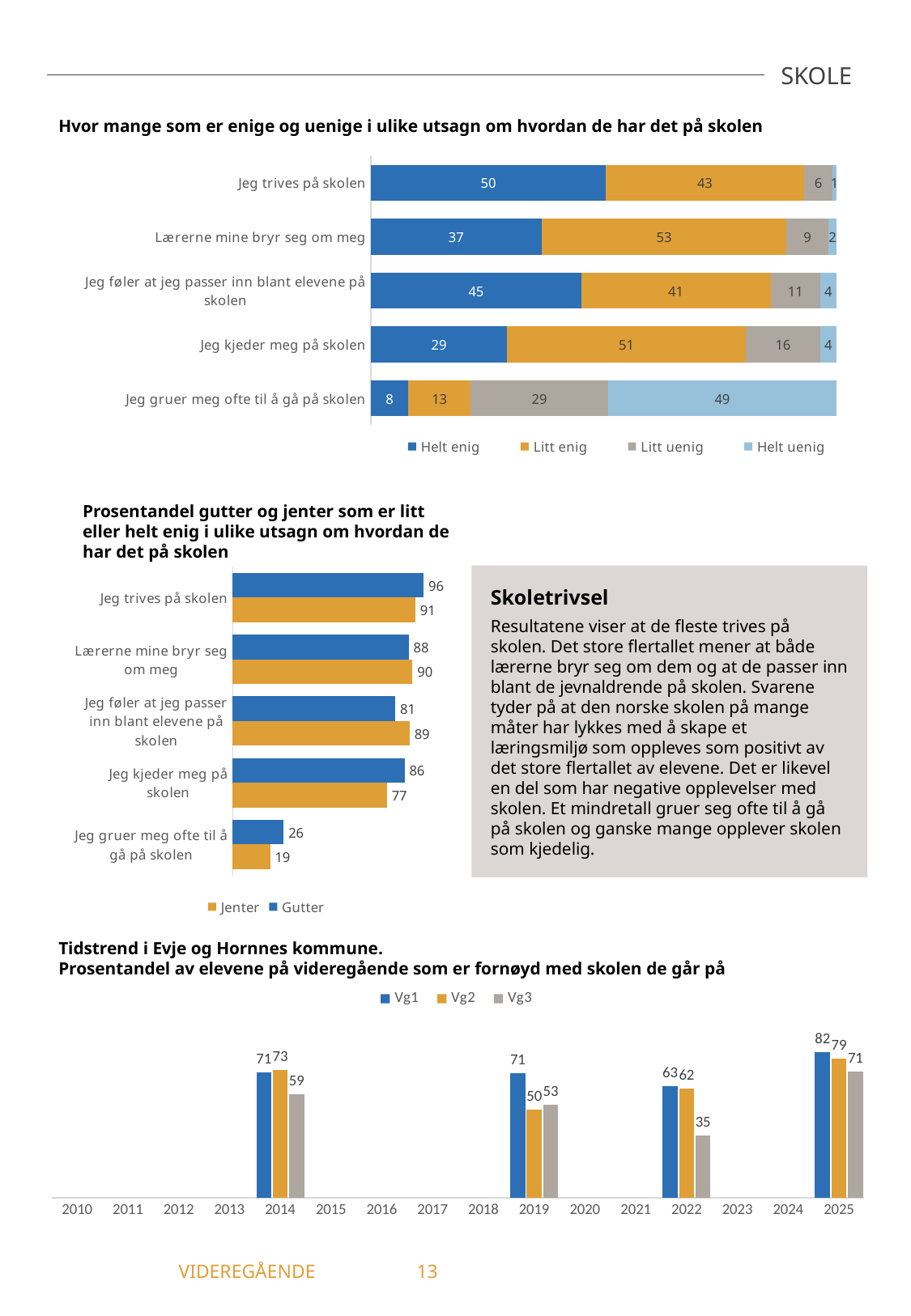
How many series does the legend of the top chart 'Hvor mange som er enige og uenige i ulike utsagn om hvordan de har det på skolen' list? 4 In the middle chart 'Prosentandel gutter og jenter som er litt eller helt enig i ulike utsagn om hvordan de har det på skolen', what is the value for Gutter on 'Jeg trives på skolen'? 96 What kind of chart is the bottom chart 'Tidstrend i Evje og Hornnes kommune'? Bar chart In the top chart 'Hvor mange som er enige og uenige i ulike utsagn om hvordan de har det på skolen', which statement has the highest 'Litt enig' value? Lærerne mine bryr seg om meg In the bottom chart 'Tidstrend i Evje og Hornnes kommune', what is the Vg3 value for 2022? 35 In the middle chart 'Prosentandel gutter og jenter som er litt eller helt enig i ulike utsagn om hvordan de har det på skolen', what is the difference between Jenter and Gutter for 'Jeg gruer meg ofte til å gå på skolen'? 7 In the top chart 'Hvor mange som er enige og uenige i ulike utsagn om hvordan de har det på skolen', what is the 'Helt uenig' value for 'Jeg gruer meg ofte til å gå på skolen'? 49 In the bottom chart 'Tidstrend i Evje og Hornnes kommune', how many years have data plotted? 4 In the top chart 'Hvor mange som er enige og uenige i ulike utsagn om hvordan de har det på skolen', what is the 'Helt enig' value for 'Jeg trives på skolen'? 50 In the top chart 'Hvor mange som er enige og uenige i ulike utsagn om hvordan de har det på skolen', what is the difference between the 'Litt uenig' values for 'Jeg kjeder meg på skolen' and 'Jeg trives på skolen'? 10 In the bottom chart 'Tidstrend i Evje og Hornnes kommune', which year has the highest Vg1 value? 2025 In the middle chart 'Prosentandel gutter og jenter som er litt eller helt enig i ulike utsagn om hvordan de har det på skolen', which is larger for 'Jeg kjeder meg på skolen': Jenter or Gutter? Gutter